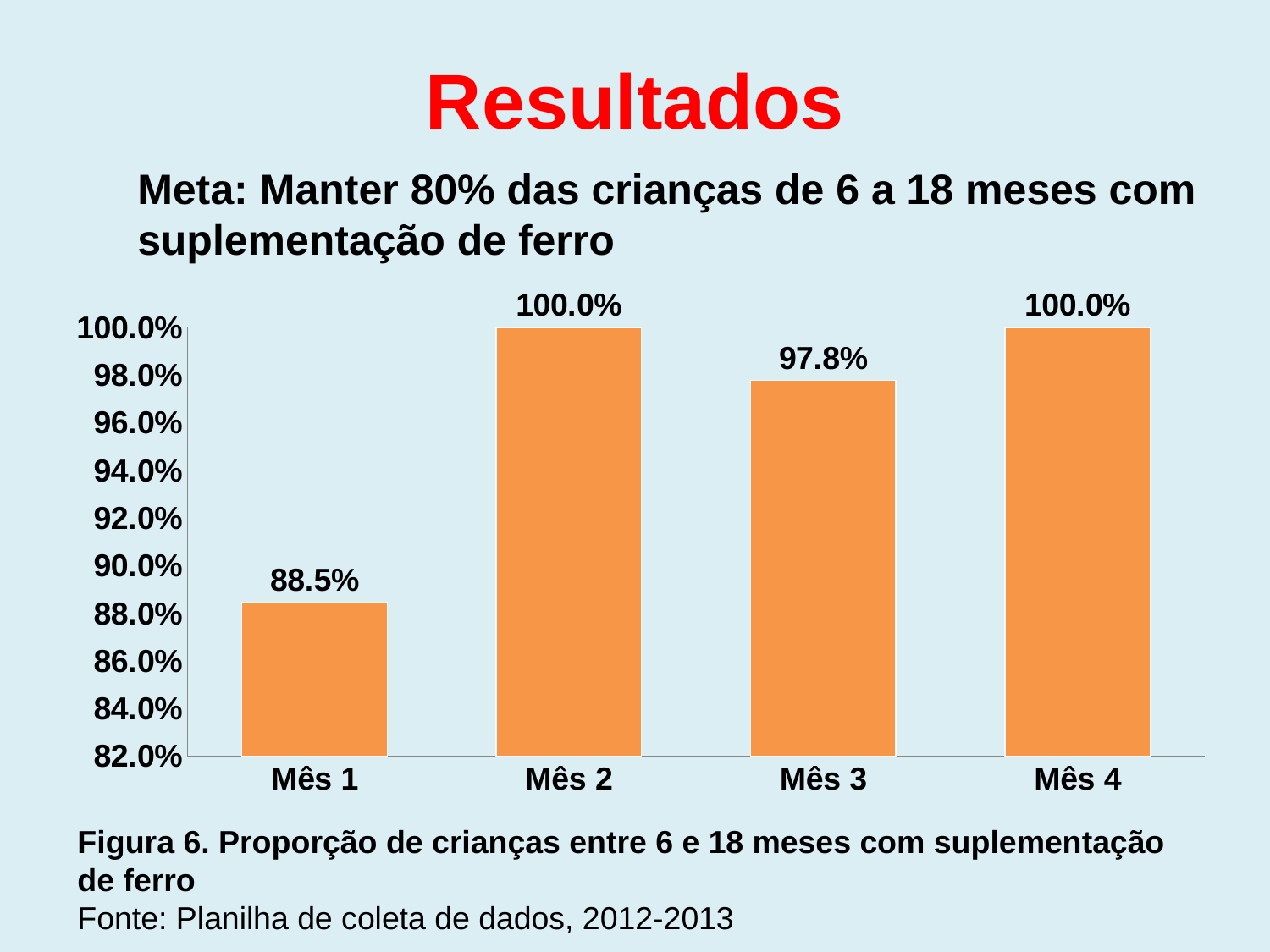
Which is larger, the value for Mês 3 or the value for Mês 1? Mês 3 What is the value for Mês 1? 88.5% What is the value for Mês 3? 97.8% What is the difference between the values for Mês 2 and Mês 1? 11.5% What is the value for Mês 2? 100.0% What is the figure caption below the chart? Figura 6. Proporção de crianças entre 6 e 18 meses com suplementação de ferro Is the value for Mês 1 greater or less than 90.0%? less How many months are shown on the x axis? 4 What kind of chart is shown on the slide? bar chart Which month has the lowest value? Mês 1 Is the value for Mês 3 greater or less than 96.0%? greater What is the difference between the values for Mês 3 and Mês 1? 9.3%